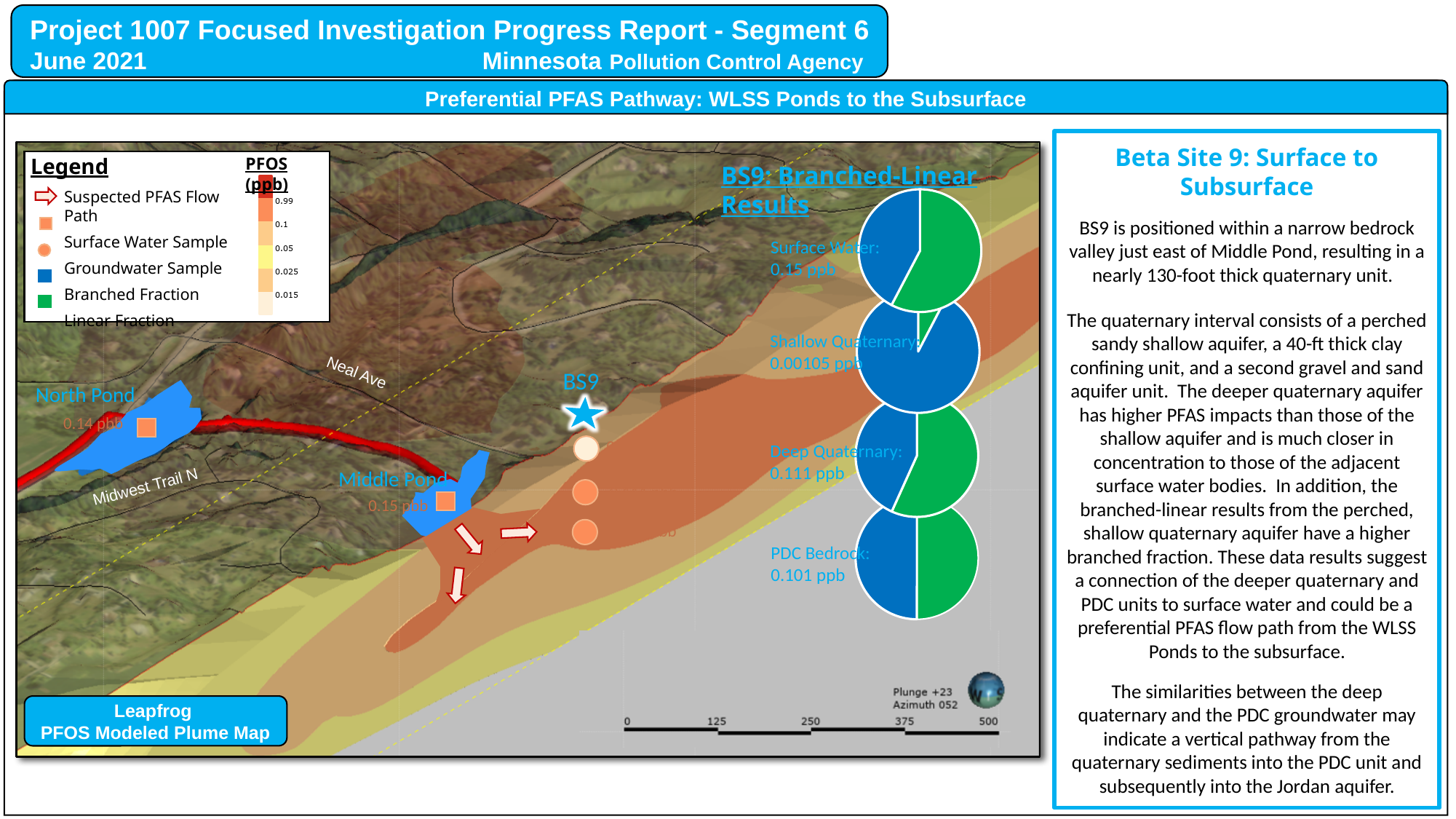
In the BS9: Branched-Linear Results pie charts, what PFOS concentration is printed for Shallow Quaternary? 0.00105 ppb According to the legend, which colour represents the Branched Fraction in the BS9 pie charts? Green Which of the four BS9 pie charts has the smallest green (Branched Fraction) slice? Shallow Quaternary In the BS9: Branched-Linear Results pie charts, what PFOS concentration is printed for Deep Quaternary? 0.111 ppb In the BS9: Branched-Linear Results pie charts, what PFOS concentration is printed for Surface Water? 0.15 ppb Among the four BS9 pie charts, which unit has the lowest printed PFOS concentration? Shallow Quaternary How many pie charts are shown in the 'BS9: Branched-Linear Results' section? 4 Among the four BS9 pie charts, which unit has the highest printed PFOS concentration? Surface Water What kind of charts are shown under the heading 'BS9: Branched-Linear Results'? Pie charts What is the difference between the printed PFOS concentrations for Surface Water and Deep Quaternary in the BS9 pie charts? 0.039 ppb In the Shallow Quaternary pie chart, which slice is larger, the blue or the green? Blue In the BS9: Branched-Linear Results pie charts, what PFOS concentration is printed for PDC Bedrock? 0.101 ppb